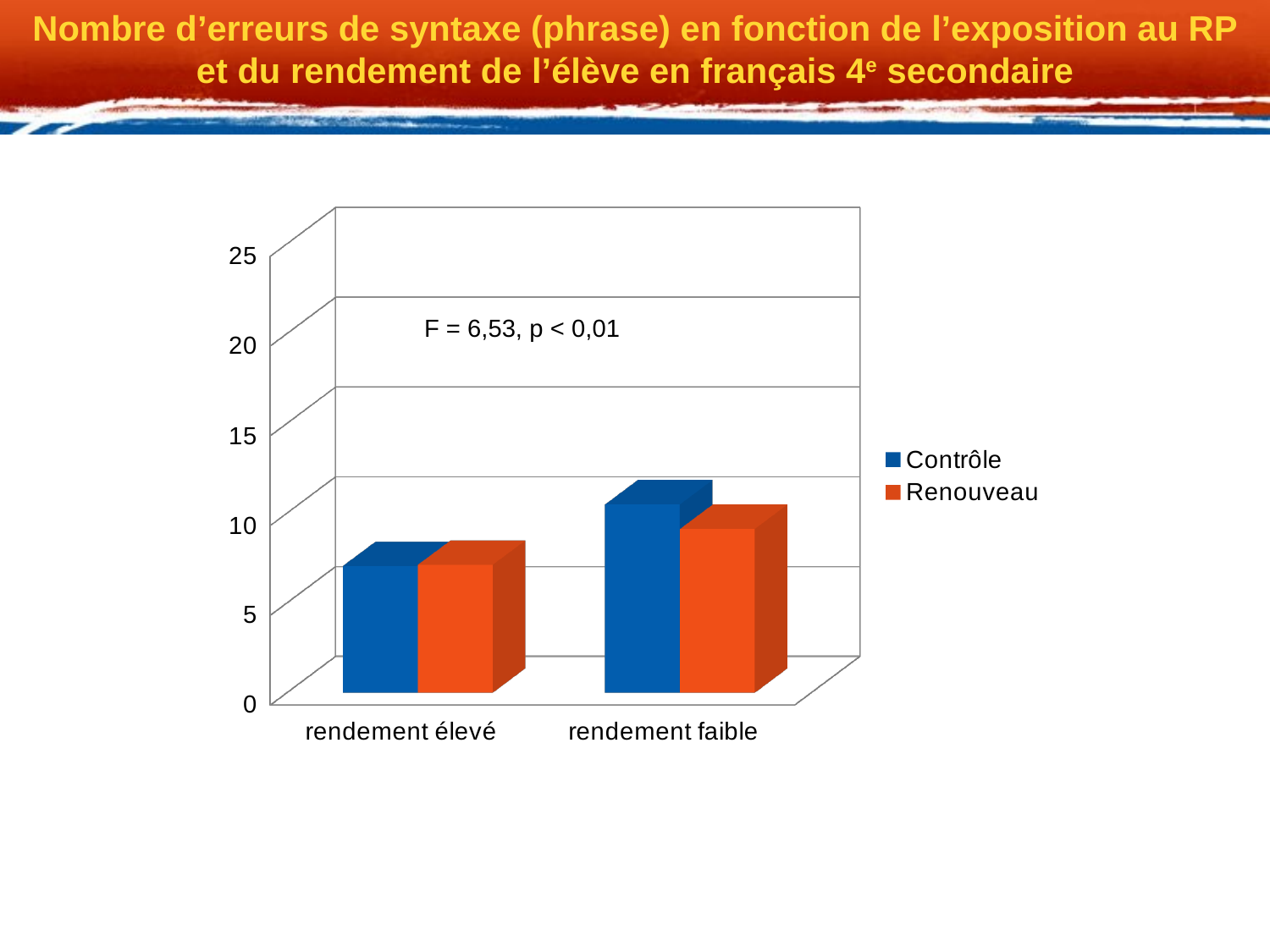
Is the Renouveau value for rendement faible greater or less than 15? less Do the values for both series rise or fall from rendement élevé to rendement faible? rise Is the Contrôle value for rendement élevé greater or less than 10? less How many categories are shown on the x axis of the chart? 2 Is the Renouveau value for rendement élevé greater or less than 10? less What statistical annotation is printed inside the chart area? F = 6,53, p < 0,01 For the Renouveau series, which category has the larger value: rendement élevé or rendement faible? rendement faible What kind of chart is shown on the slide? bar chart How many series does the legend of the chart list? 2 What are the two series named in the chart legend? Contrôle and Renouveau For the Contrôle series, which category has the larger value: rendement élevé or rendement faible? rendement faible